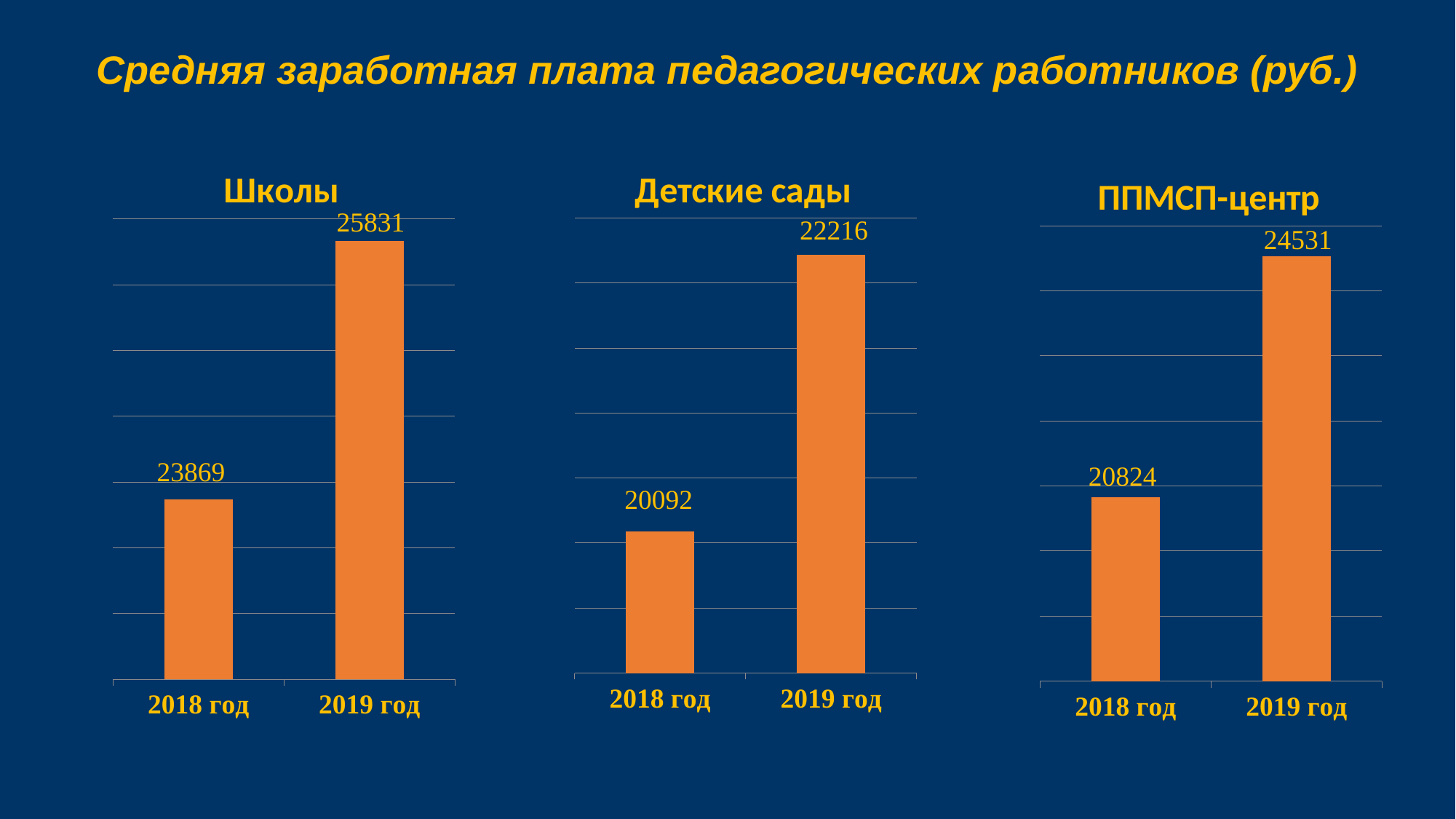
In the "ППМСП-центр" chart, what is the value for 2019 год? 24531 In the "Школы" chart, what is the difference between the 2019 год and 2018 год values? 1962 In the "Школы" chart, what is the value for 2019 год? 25831 In the "Школы" chart, what is the value for 2018 год? 23869 In the "ППМСП-центр" chart, what is the value for 2018 год? 20824 In the "Детские сады" chart, what is the value for 2018 год? 20092 In the "ППМСП-центр" chart, what is the difference between the 2019 год and 2018 год values? 3707 What kind of chart is the "ППМСП-центр" chart? Bar chart In the "Детские сады" chart, what is the value for 2019 год? 22216 How many charts are shown on the slide? 3 In the "Детские сады" chart, which year has the higher value? 2019 год In the "Детские сады" chart, what is the difference between the 2019 год and 2018 год values? 2124